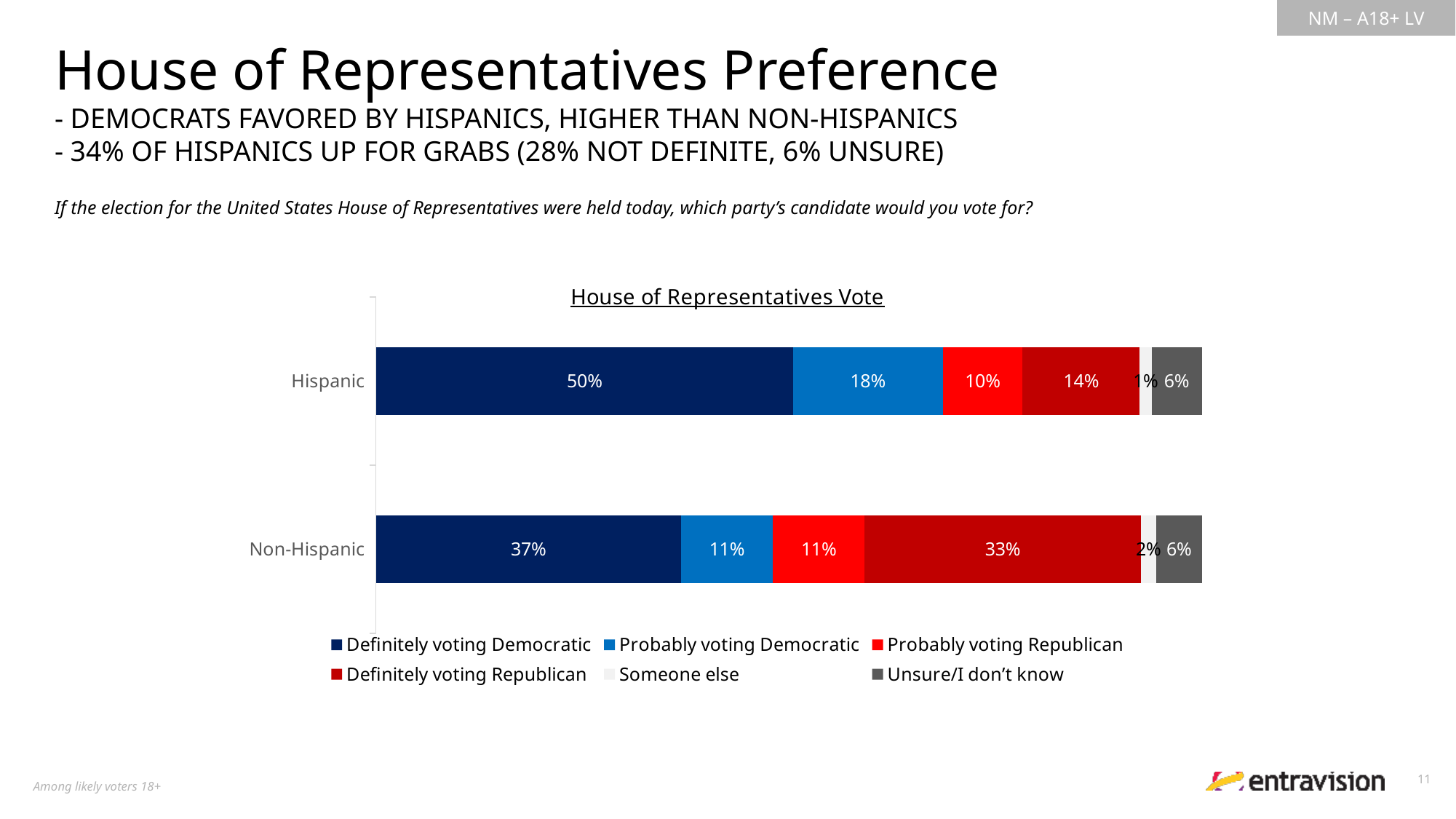
What type of chart is shown on the slide? Stacked bar chart What percentage of Hispanic respondents are definitely voting Democratic? 50% What percentage of Non-Hispanic respondents chose 'Someone else'? 2% What is the difference between the Hispanic and Non-Hispanic shares definitely voting Republican? 19% Which response category is the largest for Non-Hispanic respondents? Definitely voting Democratic How many series does the legend list? 6 Which response category is the smallest for Hispanic respondents? Someone else What percentage of Hispanic respondents are probably voting Democratic? 18% Which group has the higher share definitely voting Democratic, Hispanic or Non-Hispanic? Hispanic What percentage of Non-Hispanic respondents are definitely voting Republican? 33% What is the difference between the Hispanic and Non-Hispanic shares definitely voting Democratic? 13% How many groups (bars) are shown in the chart? 2